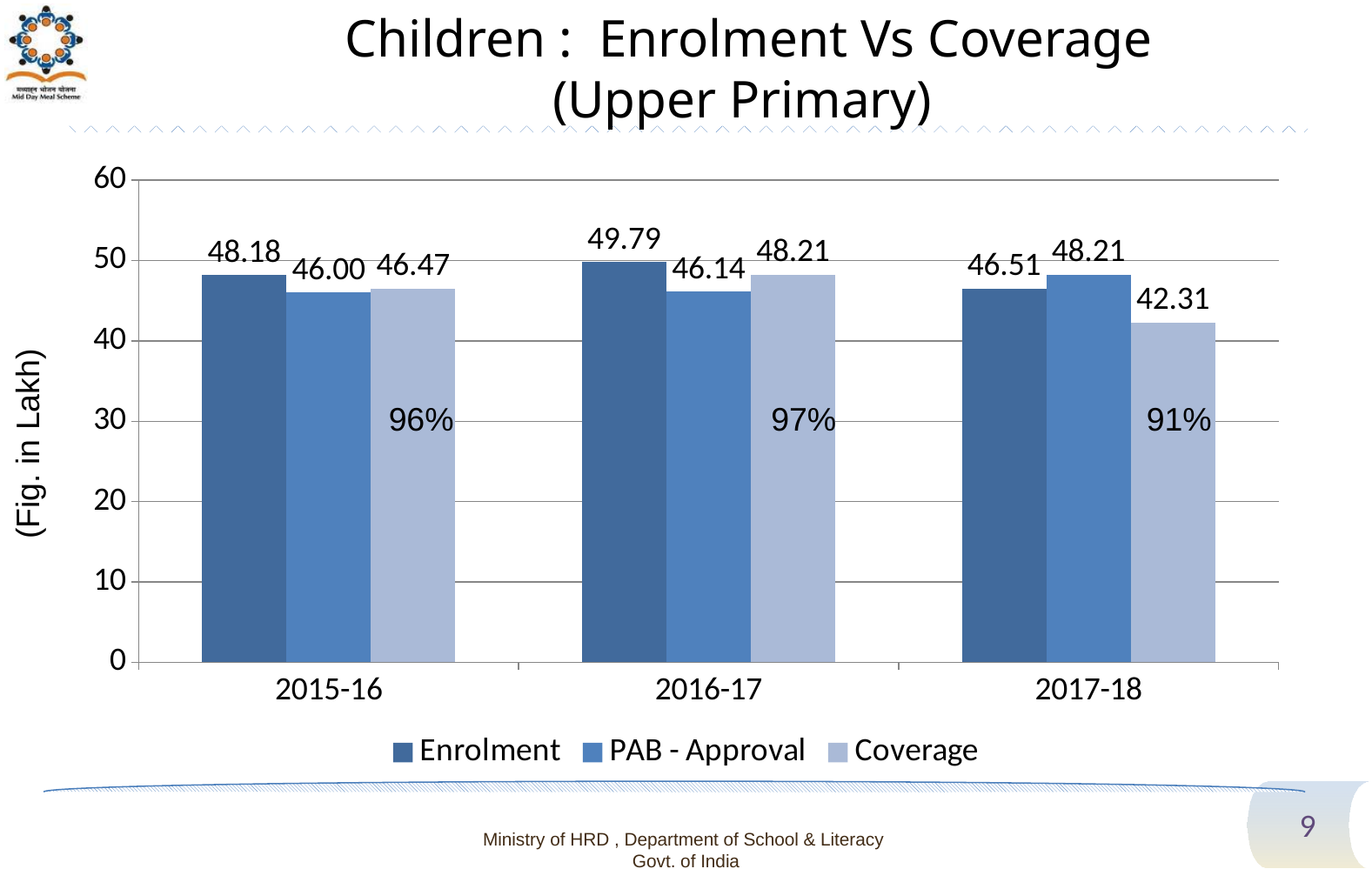
How many series does the legend list? 3 Is the Coverage value for 2016-17 greater or less than 40? greater What is the difference between Enrolment and Coverage in 2017-18? 4.20 What is the Enrolment value for 2016-17? 49.79 How many years are shown on the x axis? 3 Which year has the highest Enrolment value? 2016-17 What kind of chart is shown on the slide? bar chart What is the PAB - Approval value for 2015-16? 46.00 What is the Coverage value for 2017-18? 42.31 Which year has the lowest Coverage value? 2017-18 Which is larger in 2017-18, Enrolment or PAB - Approval? PAB - Approval What percentage is printed on the Coverage bar for 2016-17? 97%